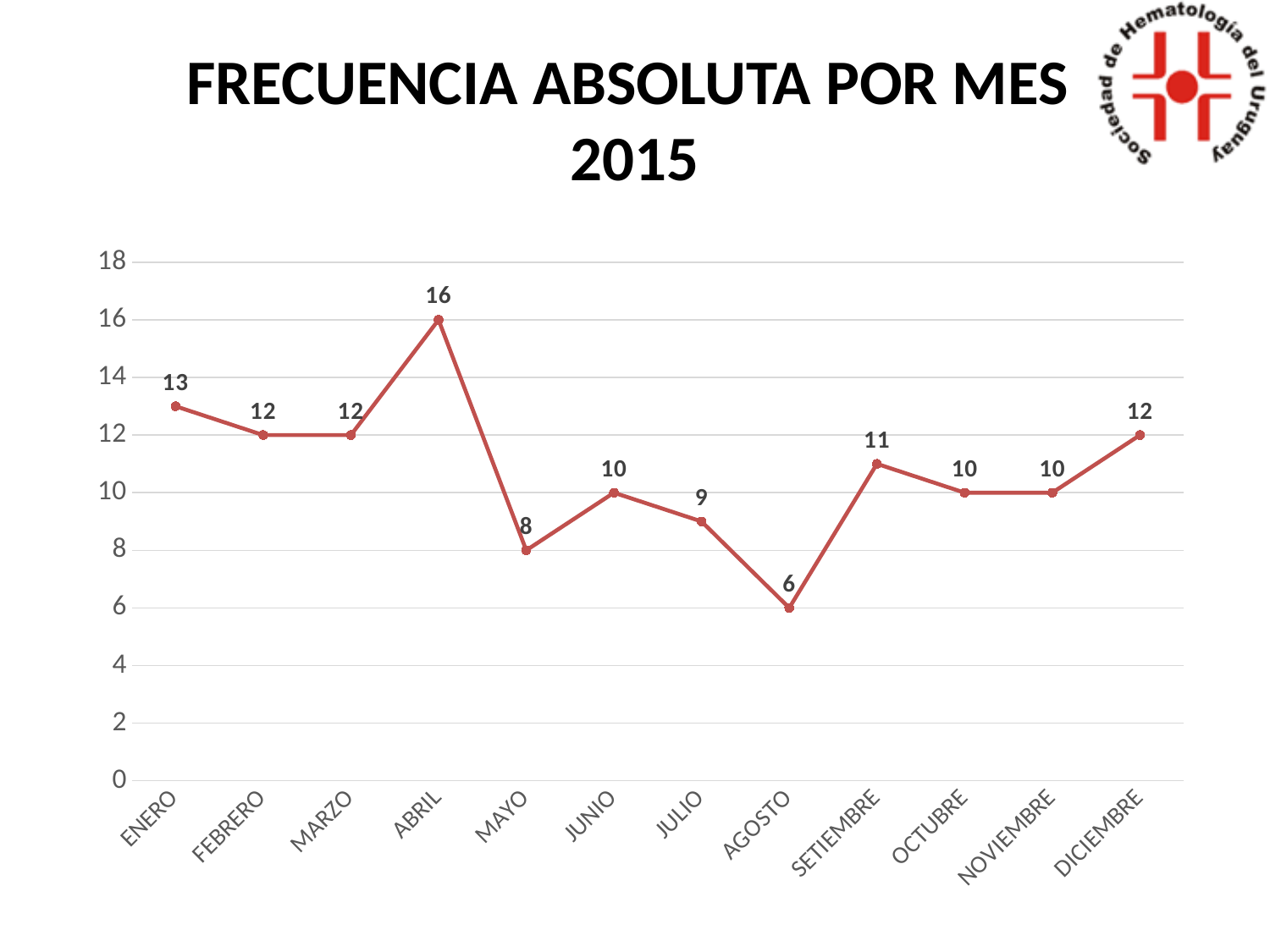
What is the difference between the values for ENERO and MAYO? 5 What is the value for SETIEMBRE? 11 What is the difference between the values for ABRIL and AGOSTO? 10 What kind of chart is shown on the slide? line chart What is the title of the chart? FRECUENCIA ABSOLUTA POR MES 2015 Is the value for ABRIL greater or less than 14? greater What is the value for AGOSTO? 6 Which is larger, the value for JUNIO or the value for JULIO? JUNIO How many months are plotted on the chart? 12 What is the value for ABRIL? 16 Which month has the lowest value? AGOSTO Which month has the highest value? ABRIL